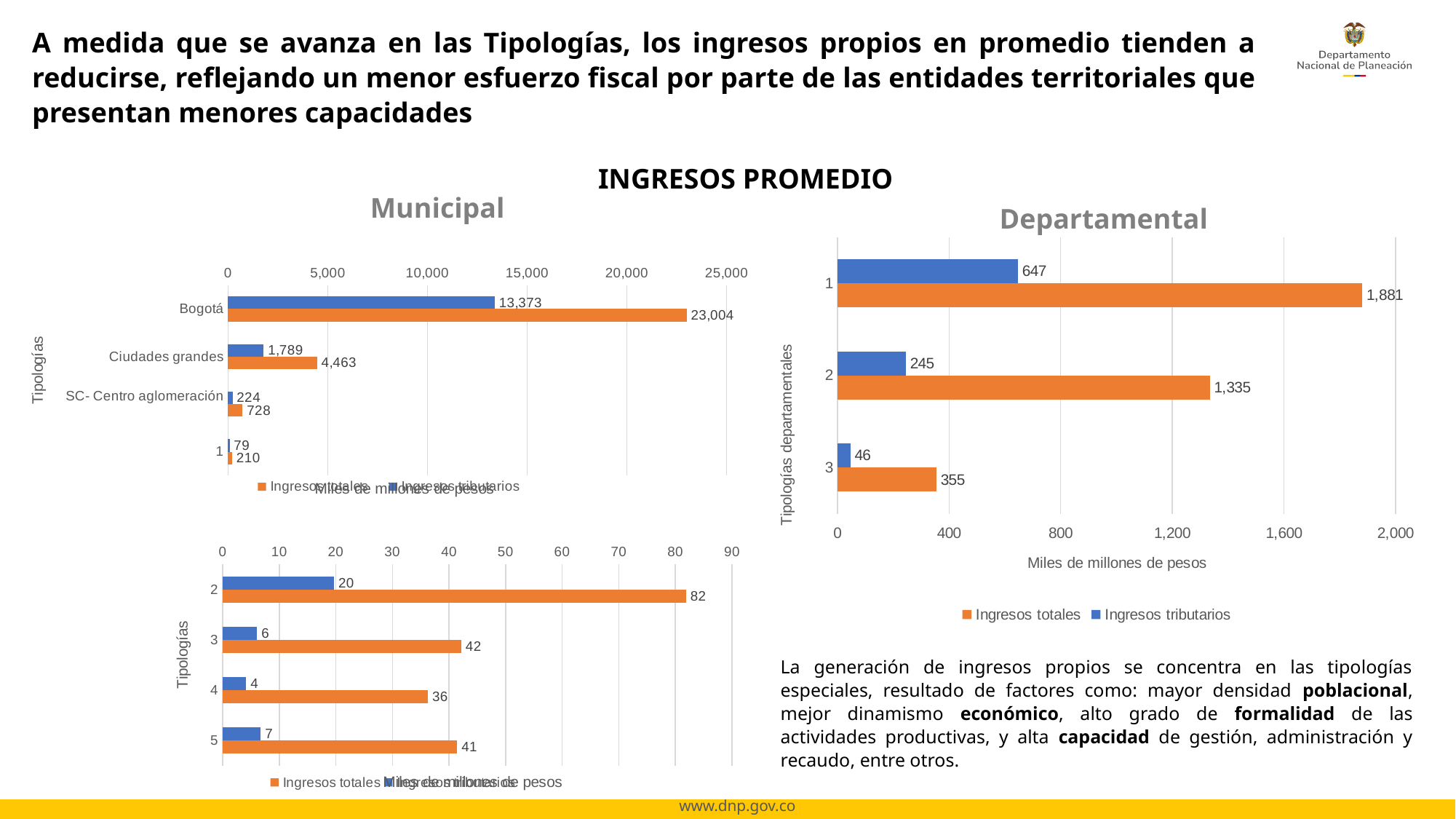
In the Departamental chart, what is the difference between Ingresos totales and Ingresos tributarios for tipología 2? 1,090 In the Departamental chart, what is the value of Ingresos tributarios for tipología 3? 46 In the bottom-left chart, which tipología has the highest Ingresos totales? 2 In the bottom-left chart, which is larger: Ingresos totales for tipología 3 or for tipología 5? Tipología 3 In the top-left Municipal chart, what is the value of Ingresos tributarios for Bogotá? 13,373 In the Departamental chart, what is the value of Ingresos totales for tipología 1? 1,881 In the Departamental chart, which tipología has the lowest Ingresos tributarios? 3 In the bottom-left chart, what is the value of Ingresos totales for tipología 4? 36 How many series does the legend of the Departamental chart list? 2 In the top-left Municipal chart, what is the value of Ingresos totales for Ciudades grandes? 4,463 How many categories are shown in the top-left Municipal chart? 4 What type of chart is the Departamental chart? Bar chart